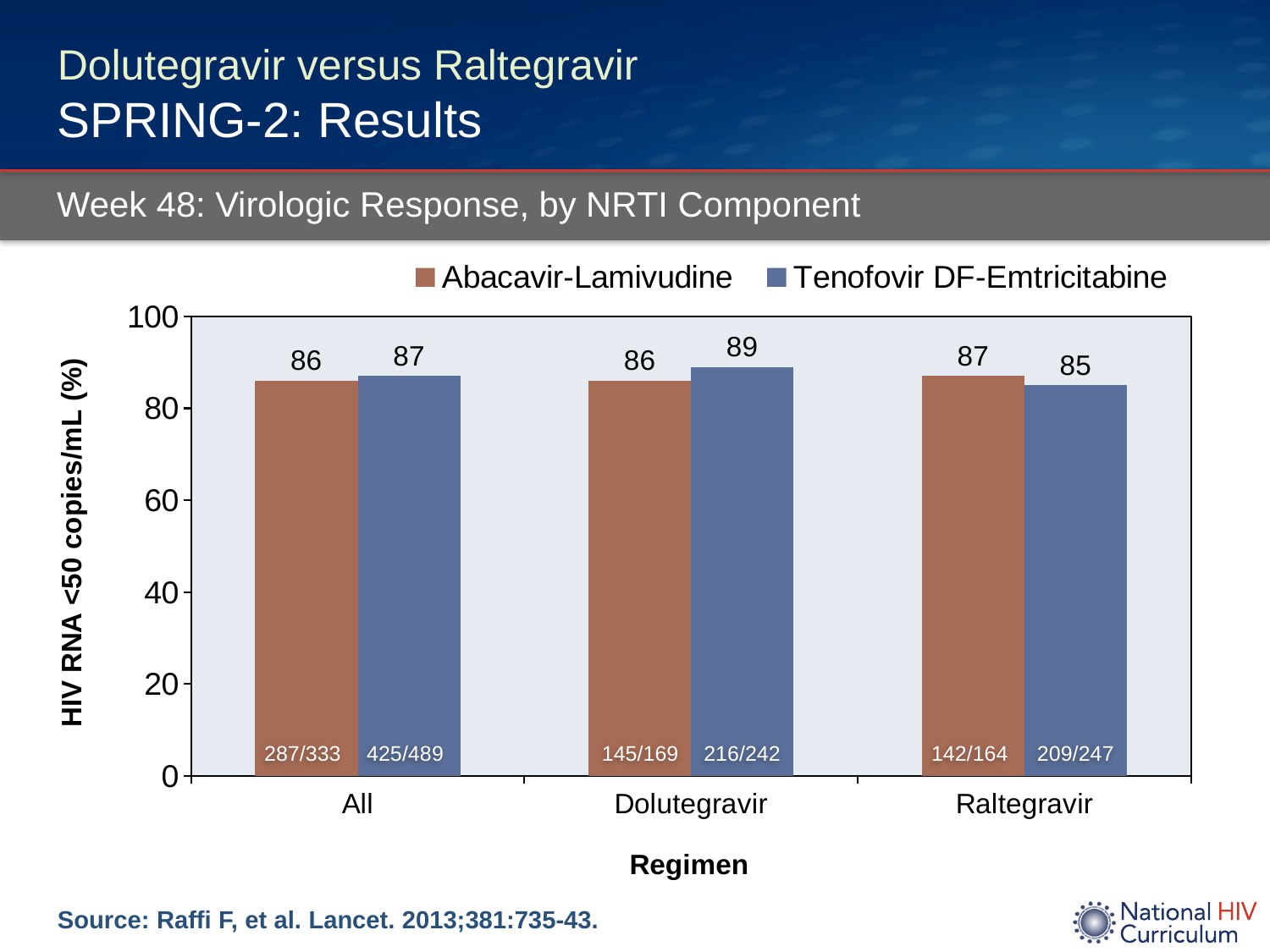
Which regimen group has the lowest value for Tenofovir DF-Emtricitabine? Raltegravir What is the value for Tenofovir DF-Emtricitabine in the Raltegravir group? 85 In the Raltegravir group, which series has the larger value, Abacavir-Lamivudine or Tenofovir DF-Emtricitabine? Abacavir-Lamivudine What is the difference between the Tenofovir DF-Emtricitabine and Abacavir-Lamivudine values in the Dolutegravir group? 3 How many series does the legend list? 2 What is the value for Abacavir-Lamivudine in the All group? 86 What is the value for Tenofovir DF-Emtricitabine in the Dolutegravir group? 89 What kind of chart is shown on the slide? Bar chart Which regimen group has the highest value for Tenofovir DF-Emtricitabine? Dolutegravir What is the value for Abacavir-Lamivudine in the Raltegravir group? 87 How many regimen groups are shown on the x axis? 3 What is the label of the y axis? HIV RNA <50 copies/mL (%)